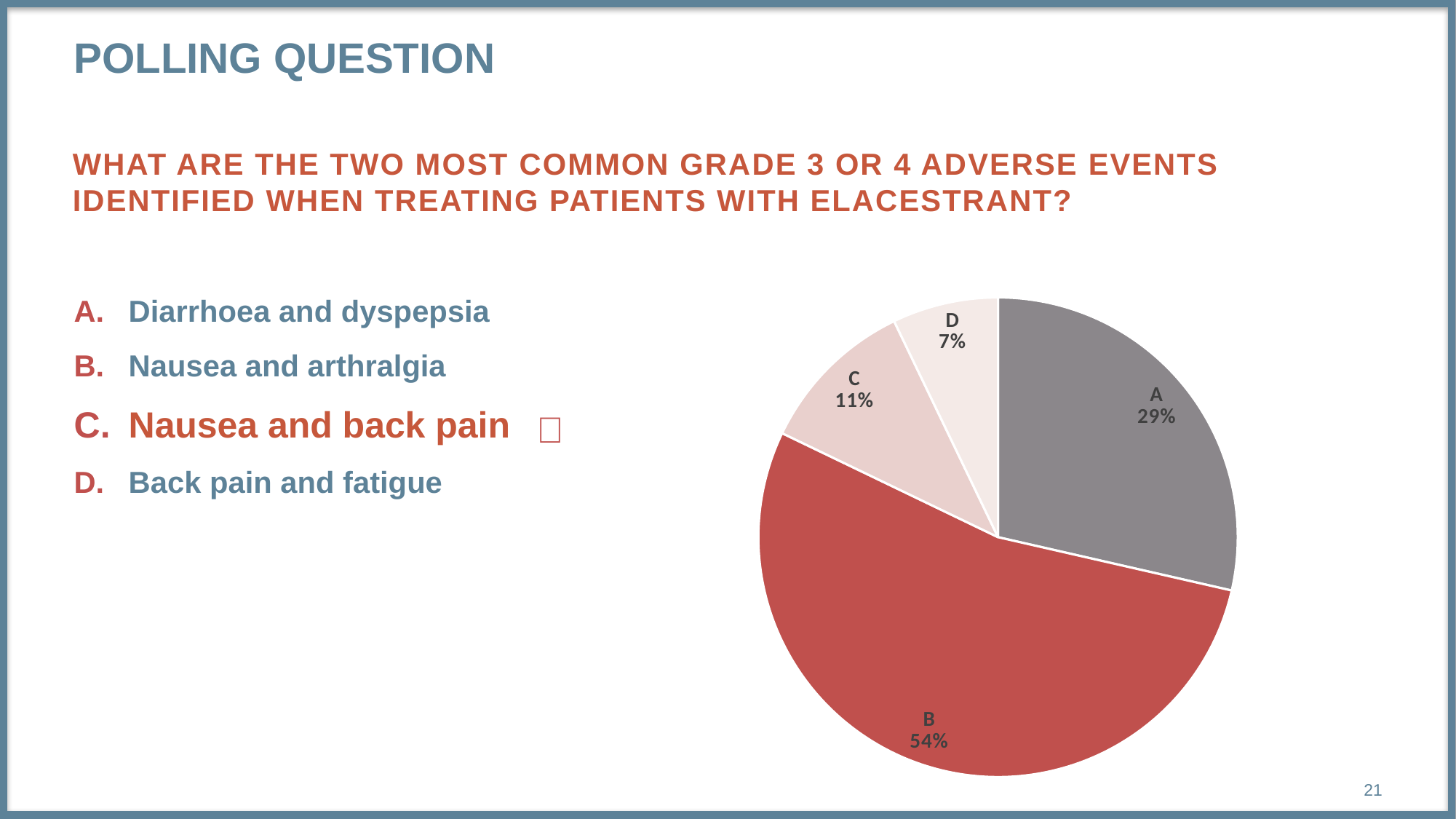
What colour is slice B in the pie chart? red What kind of chart is shown on the slide? pie chart What percentage of the pie is slice C? 11% Which slice of the pie is the smallest? D Which is larger, slice A or slice C? A What is the combined share of slices C and D? 18% What percentage of the pie is slice A? 29% What percentage of the pie is slice B? 54% Which slice of the pie is the largest? B What percentage of the pie is slice D? 7% What is the difference in percentage points between slice B and slice A? 25 How many slices does the pie chart have? 4